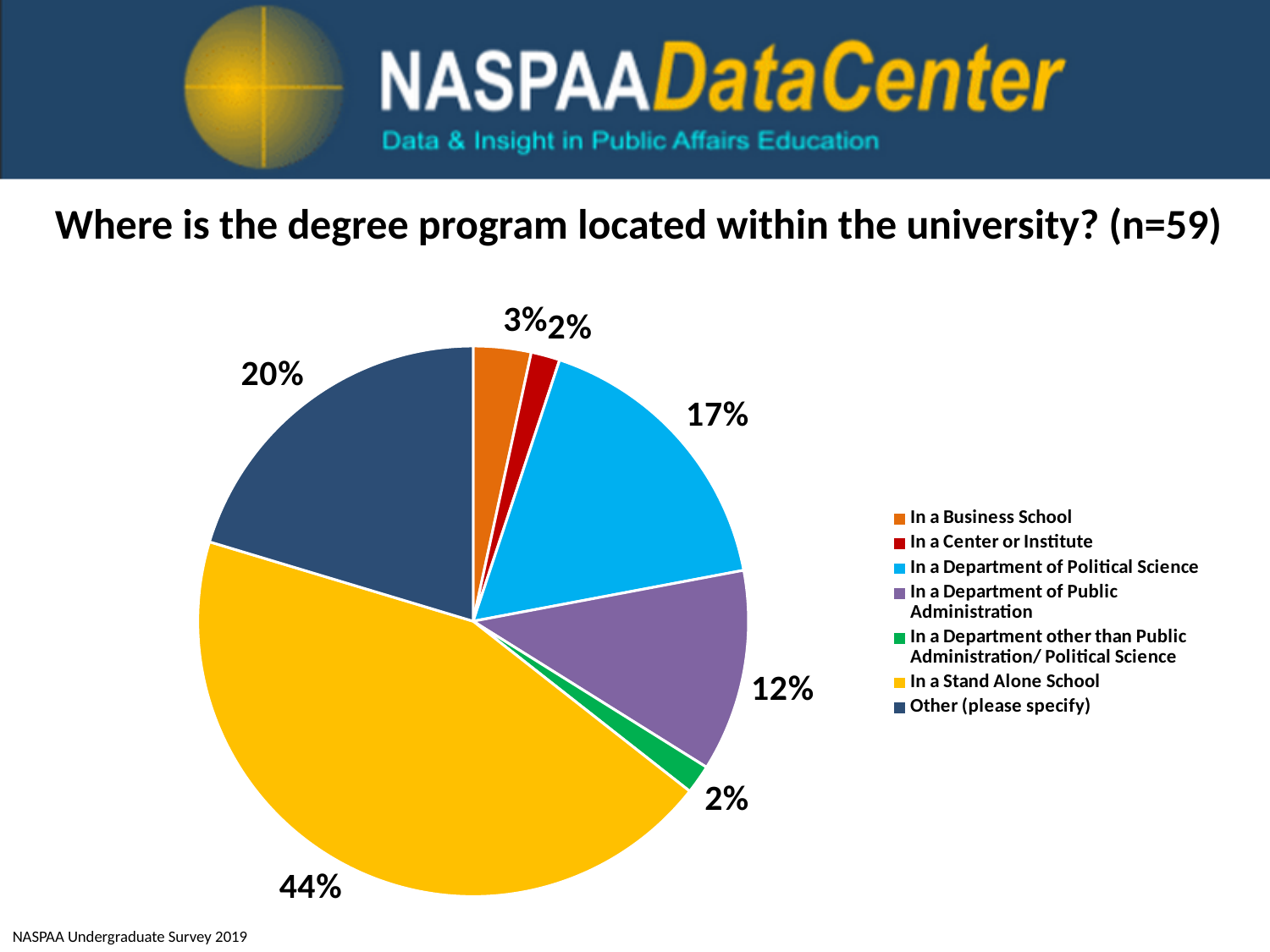
What is the sample size (n) stated in the chart title? 59 Which is larger: the share in a Department of Political Science or the share in a Department of Public Administration? In a Department of Political Science What share of degree programs are located in a Department of Public Administration? 12% What is the difference in percentage points between the Stand Alone School share and the 'Other (please specify)' share? 24 percentage points How many categories does the legend list? 7 What share of degree programs fall under 'Other (please specify)'? 20% What is the difference in percentage points between the Department of Political Science share and the Department of Public Administration share? 5 percentage points What type of chart is shown on the slide? Pie chart What share of degree programs are located in a Stand Alone School? 44% What share of degree programs are located in a Department of Political Science? 17% Which location has the largest share of degree programs? In a Stand Alone School What share of degree programs are located in a Business School? 3%